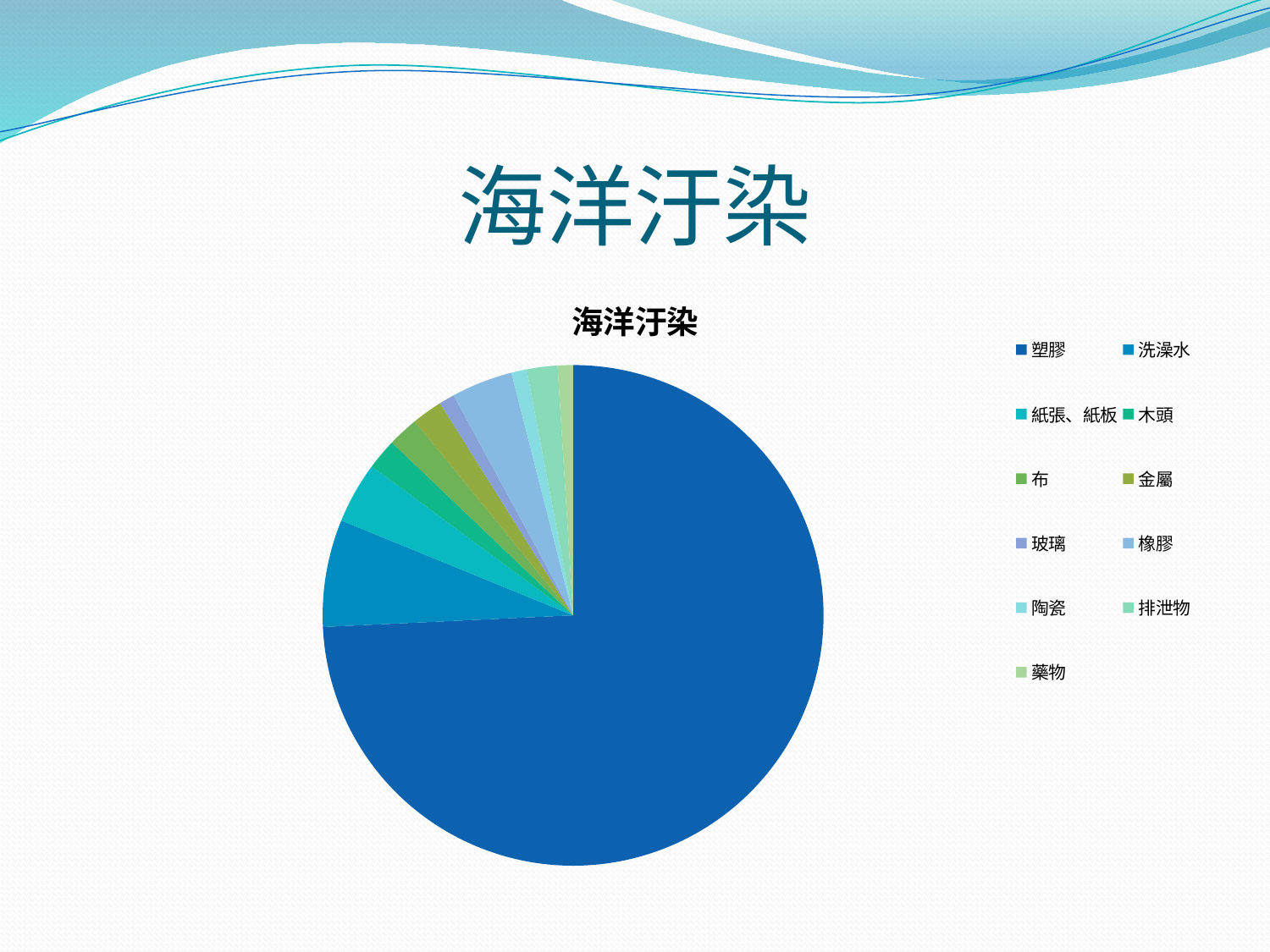
Which category is listed first in the legend? 塑膠 What is the title of the chart? 海洋汙染 Which slice is larger, 木頭 or 塑膠? 塑膠 Which slice is larger, 洗澡水 or 紙張、紙板? 洗澡水 Which slice is larger, 塑膠 or 洗澡水? 塑膠 How many categories does the pie chart's legend list? 11 Which category has the largest slice of the pie? 塑膠 What kind of chart is shown on the slide? pie chart